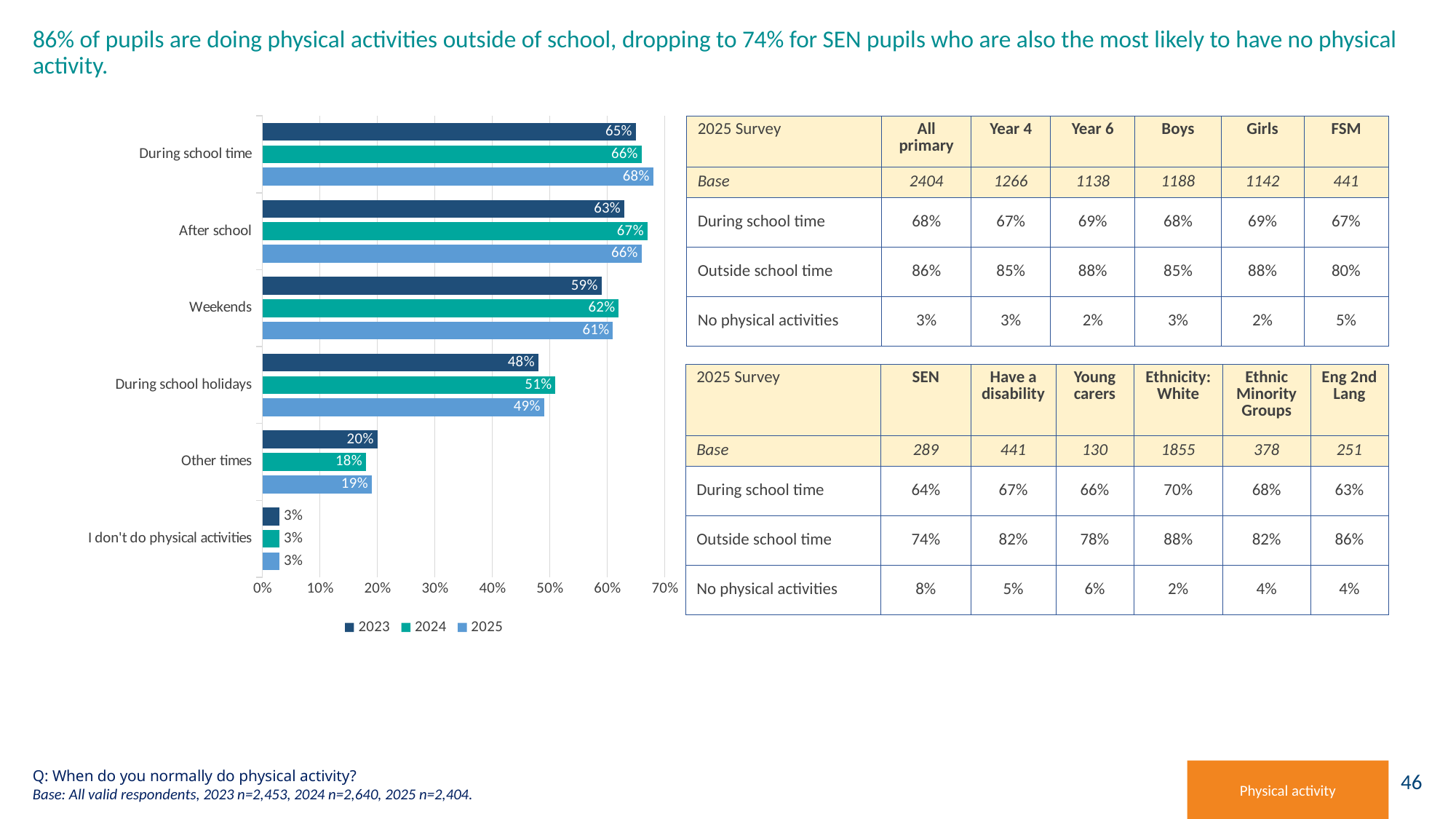
What is the difference between the 2024 and 2023 values for 'After school'? 4% How many series does the legend list? 3 What is the 2023 value for 'Weekends'? 59% How many categories are shown on the bar chart? 6 Which is larger for 'During school holidays': the 2024 value or the 2025 value? 2024 What is the difference between the 2025 values for 'During school time' and 'Weekends'? 7% Which category has the highest 2025 value? During school time Which category has the lowest values across all three years? I don't do physical activities Which years are listed in the chart legend? 2023, 2024, 2025 What kind of chart is shown on the slide? Bar chart What is the 2025 value for 'During school time'? 68% What is the 2024 value for 'Other times'? 18%